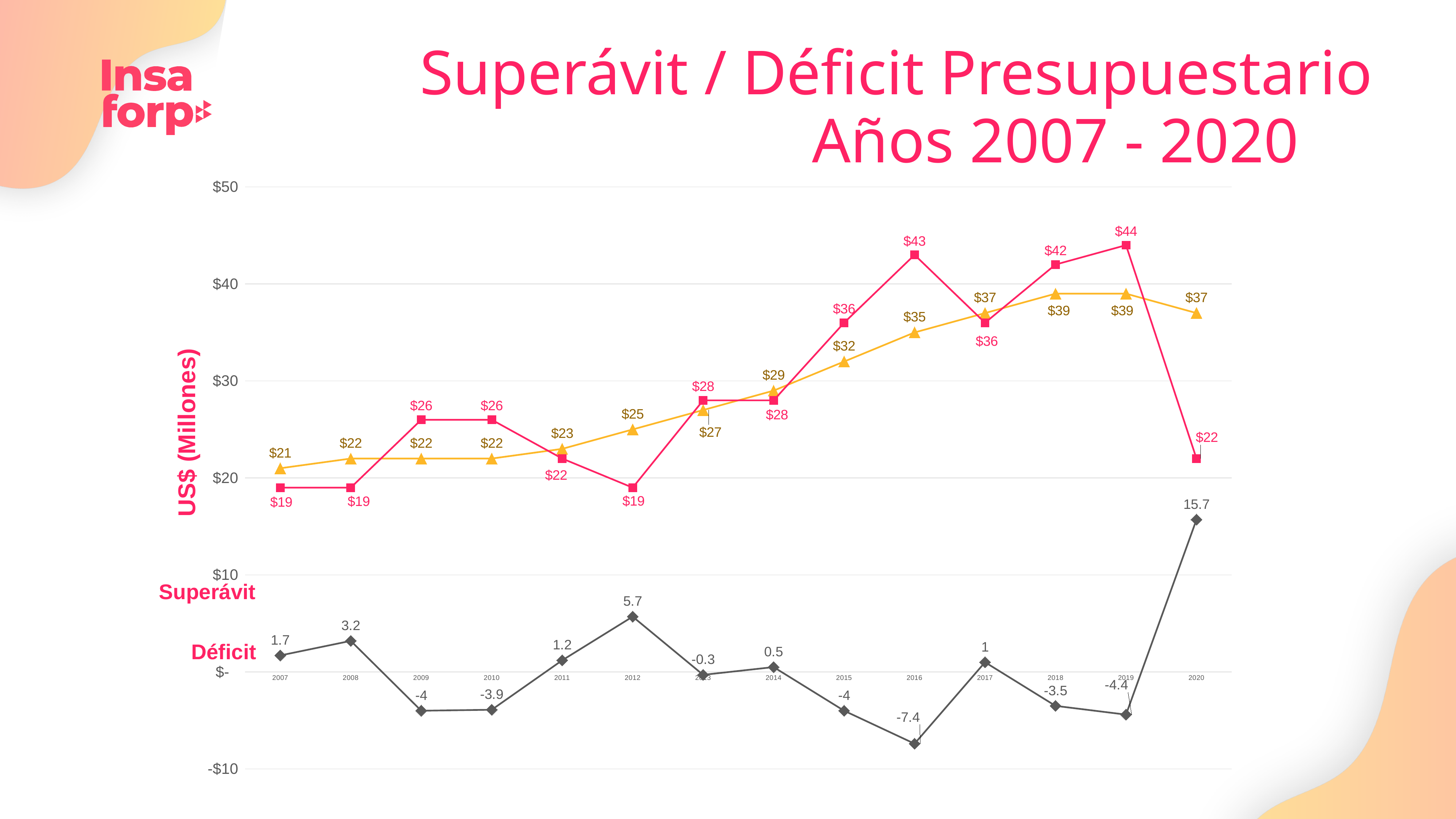
What is the value of the grey diamond-marker series in 2016? -7.4 In which year does the grey diamond-marker series reach its lowest value? 2016 Does the orange triangle-marker series generally rise or fall from 2007 to 2019? rise What is the difference between the pink square-marker series values in 2016 and 2017? $7 What is the value of the pink square-marker series in 2019? $44 In which year does the pink square-marker series reach its highest value? 2019 In which year does the grey diamond-marker series reach its highest value? 2020 What kind of chart is shown on the slide? line chart In 2018, which series has the larger value: the pink square-marker series or the orange triangle-marker series? pink square-marker series What is the title of the chart? Superávit / Déficit Presupuestario Años 2007 - 2020 What is the value of the orange triangle-marker series in 2015? $32 How many years are plotted along the x axis? 14